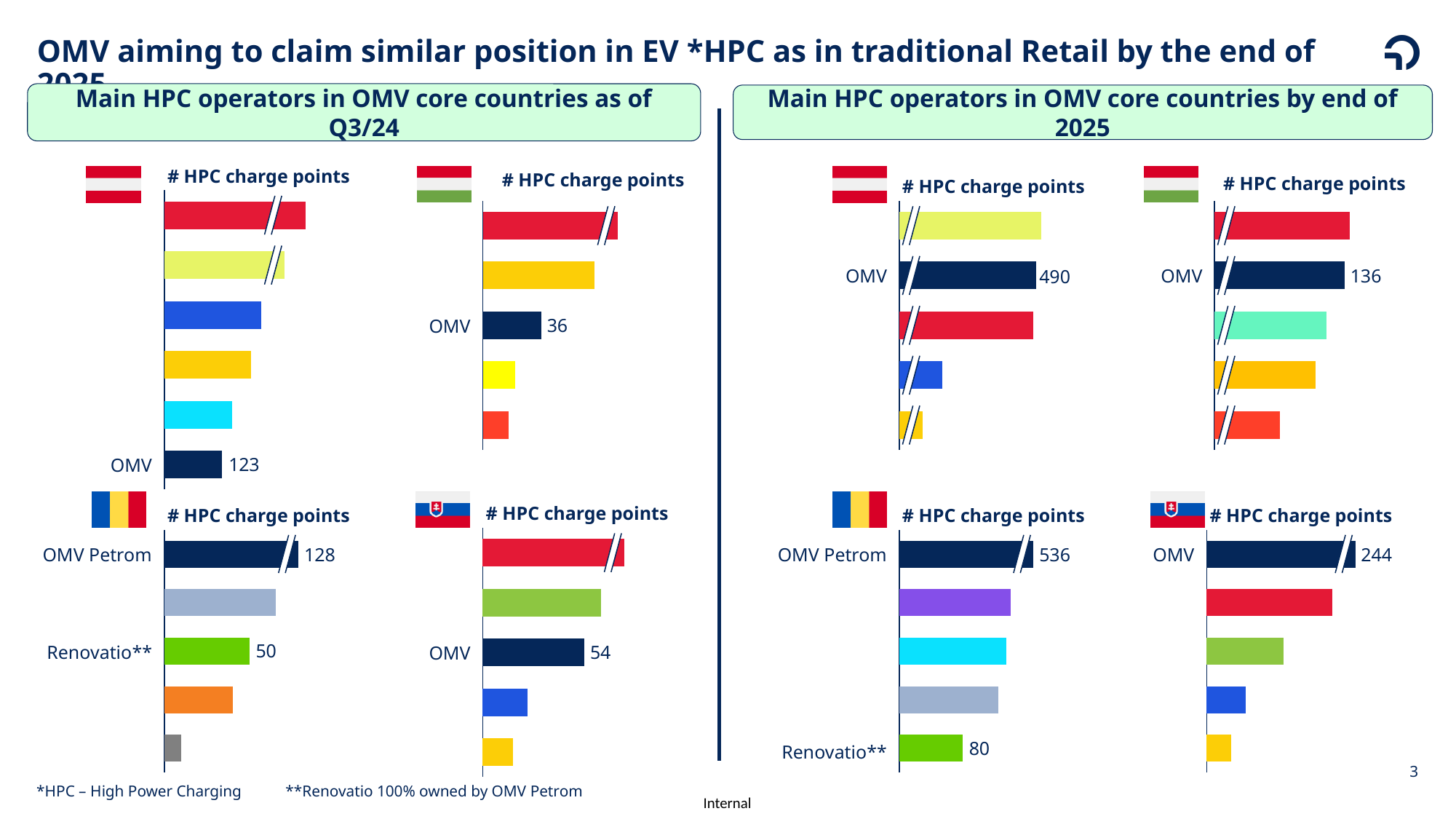
In the 'Main HPC operators in OMV core countries by end of 2025' panel, how many HPC charge points does OMV have in the bottom-right chart (Slovak flag)? 244 In the 'Main HPC operators in OMV core countries as of Q3/24' panel, how many HPC charge points does OMV have in the top-right chart (Hungarian flag)? 36 How many bars are shown in the top-left chart (Austrian flag) of the 'as of Q3/24' panel? 6 In the 'Main HPC operators in OMV core countries as of Q3/24' panel, how many HPC charge points does Renovatio** have in the bottom-left chart (Romanian flag)? 50 In the 'Main HPC operators in OMV core countries as of Q3/24' panel, how many HPC charge points does OMV Petrom have in the bottom-left chart (Romanian flag)? 128 In the 'Main HPC operators in OMV core countries by end of 2025' panel, how many HPC charge points does OMV Petrom have in the bottom-left chart (Romanian flag)? 536 In the 'Main HPC operators in OMV core countries as of Q3/24' panel, how many HPC charge points does OMV have in the top-left chart (Austrian flag)? 123 In the bottom-left chart (Romanian flag) of the 'as of Q3/24' panel, which is larger: OMV Petrom or Renovatio**? OMV Petrom In the bottom-left chart (Romanian flag) of the 'by end of 2025' panel, what is the difference between the OMV Petrom and Renovatio** values? 456 In the 'Main HPC operators in OMV core countries by end of 2025' panel, how many HPC charge points does OMV have in the top-right chart (Hungarian flag)? 136 In the 'Main HPC operators in OMV core countries by end of 2025' panel, how many HPC charge points does OMV have in the top-left chart (Austrian flag)? 490 In the 'Main HPC operators in OMV core countries as of Q3/24' panel, how many HPC charge points does OMV have in the bottom-right chart (Slovak flag)? 54